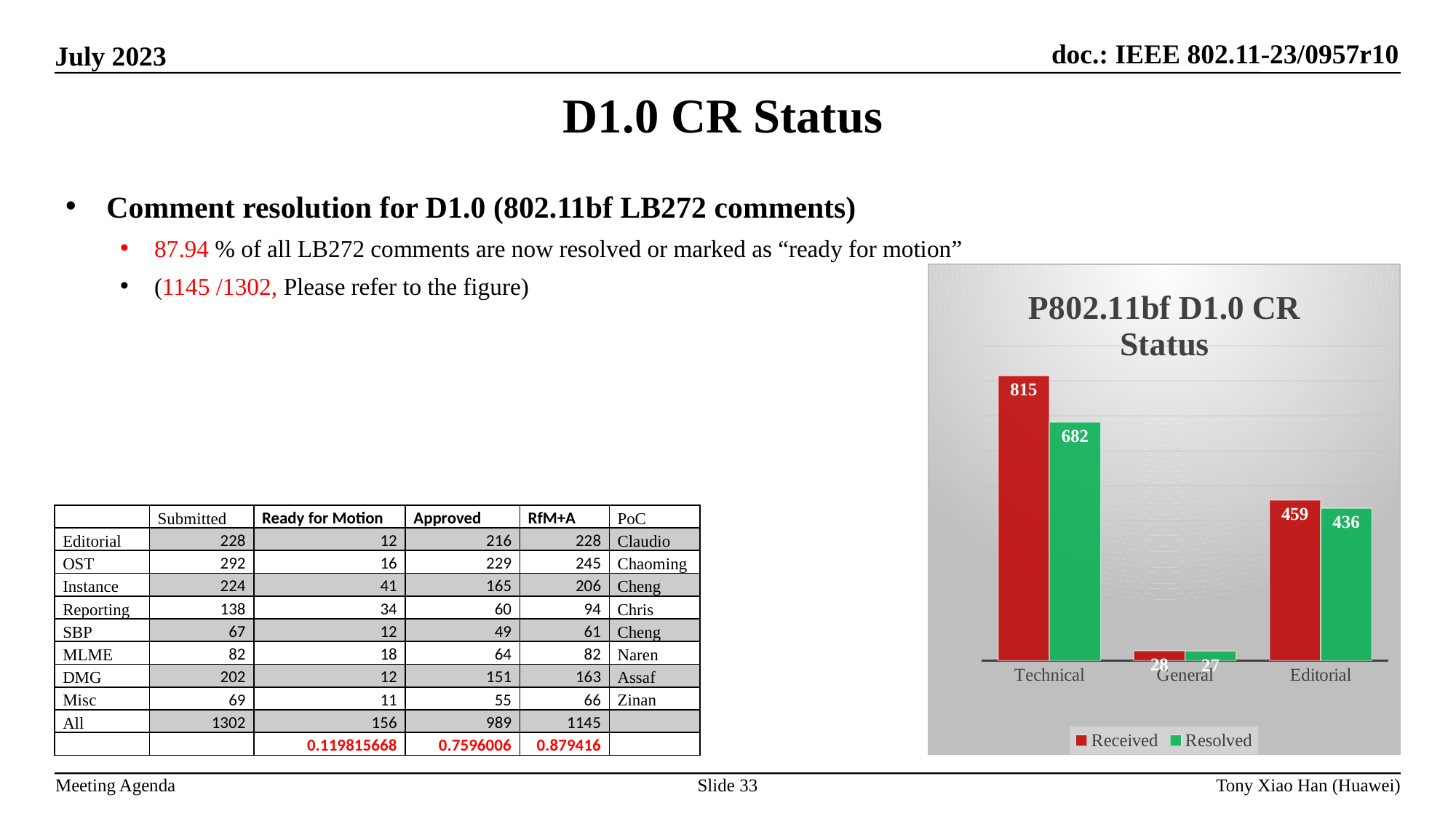
What type of chart is shown? Bar chart Which is larger, the Received value for Editorial or the Resolved value for Technical? Resolved value for Technical How many categories are shown on the x axis? 3 What is the Resolved value for Editorial? 436 What is the difference between Received and Resolved for Editorial? 23 What is the difference between Received and Resolved for Technical? 133 Which category has the lowest Resolved value? General What is the Resolved value for Technical? 682 How many series does the legend list? 2 What is the Received value for General? 28 What is the Received value for Technical? 815 Which category has the highest Received value? Technical